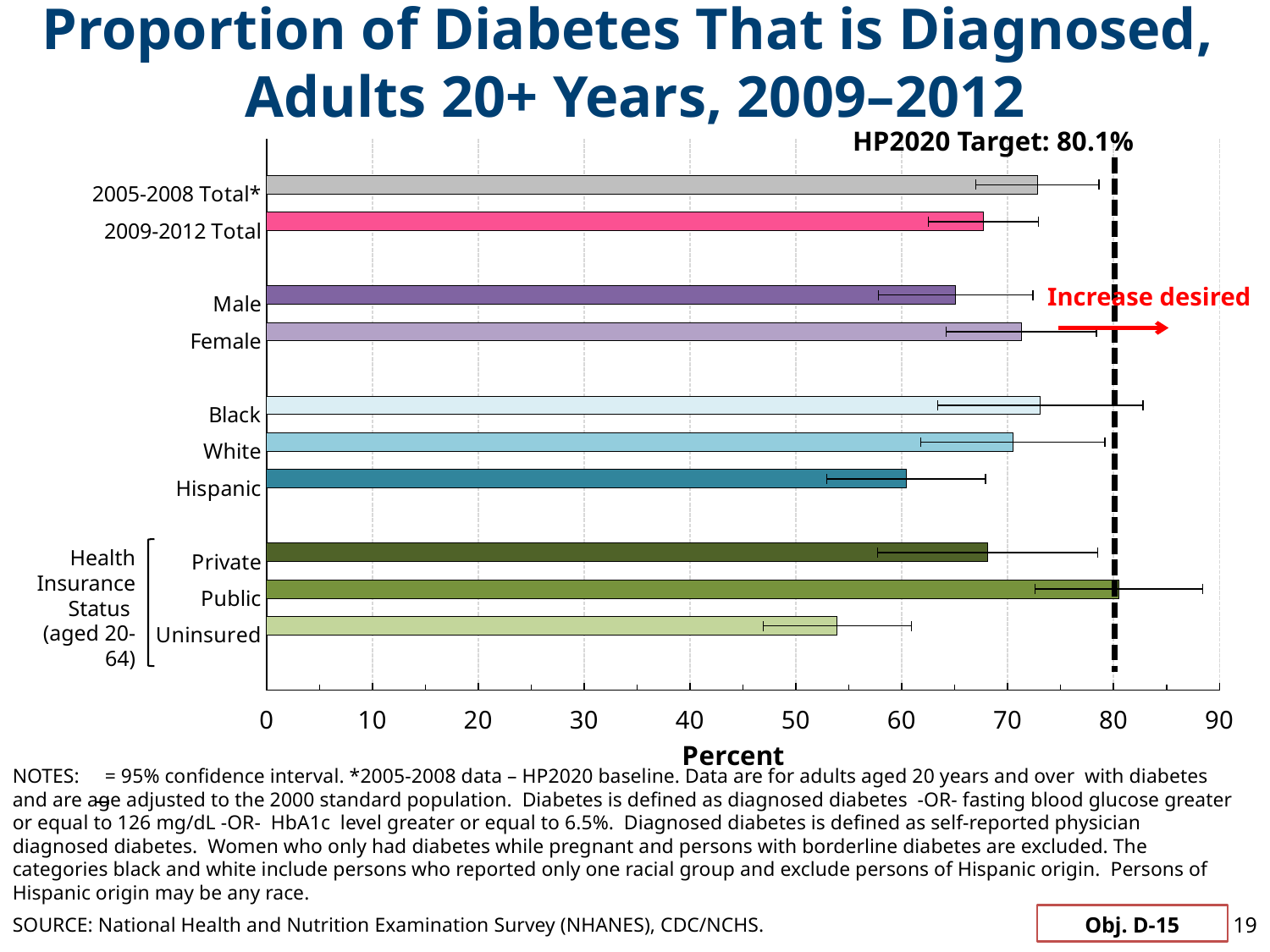
What kind of chart is shown on the slide? bar chart Is the value for Black greater or less than 70? greater Which category has the lowest proportion of diagnosed diabetes? Uninsured Which category has the highest proportion of diagnosed diabetes? Public What is the label of the horizontal axis? Percent Is the value for Uninsured greater or less than 60? less Is the value for Male greater or less than 70? less What is the HP2020 Target value shown on the chart? 80.1% How many bars (categories) are plotted in the chart? 10 Which is larger, the value for Male or the value for Female? Female Which is larger, the value for Hispanic or the value for White? White